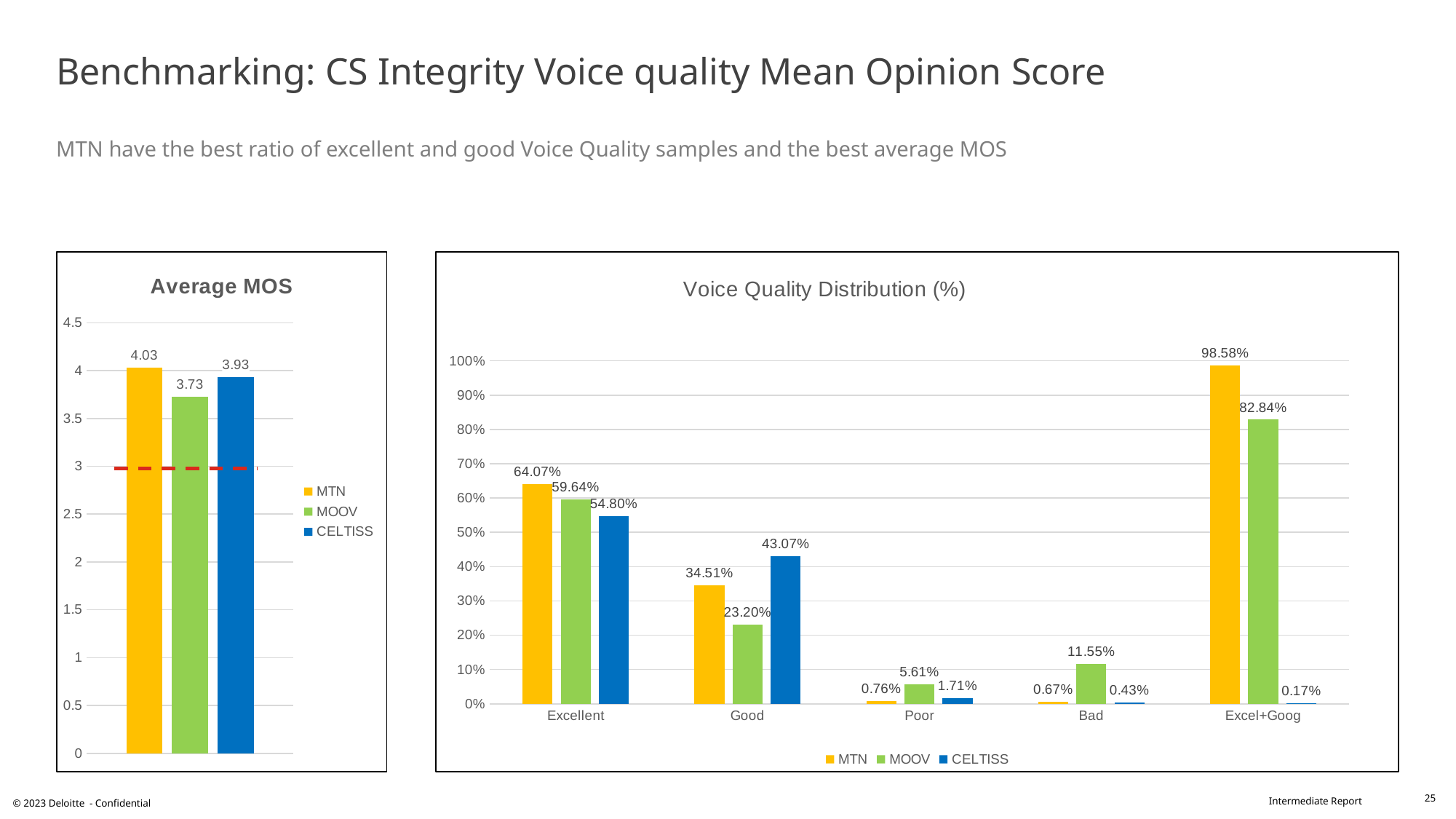
In the Average MOS chart, what is the difference between the MTN and CELTISS values? 0.1 What kind of chart is the Voice Quality Distribution (%) chart? Bar chart In the Voice Quality Distribution (%) chart, what is the value for MOOV in the Excellent category? 59.64% In the Voice Quality Distribution (%) chart, what is the value for MTN in the Poor category? 0.76% In the Average MOS chart, how many series does the legend list? 3 In the Voice Quality Distribution (%) chart, how many categories are shown on the x axis? 5 In the Voice Quality Distribution (%) chart, which operator has the highest value in the Bad category? MOOV In the Voice Quality Distribution (%) chart, what is the difference between MTN and MOOV in the Excel+Goog category? 15.74% In the Voice Quality Distribution (%) chart, what is the value for CELTISS in the Good category? 43.07% In the Voice Quality Distribution (%) chart, which is larger in the Good category: MTN or MOOV? MTN In the Average MOS chart, which operator has the lowest average MOS? MOOV In the Average MOS chart, what is the value for MTN? 4.03